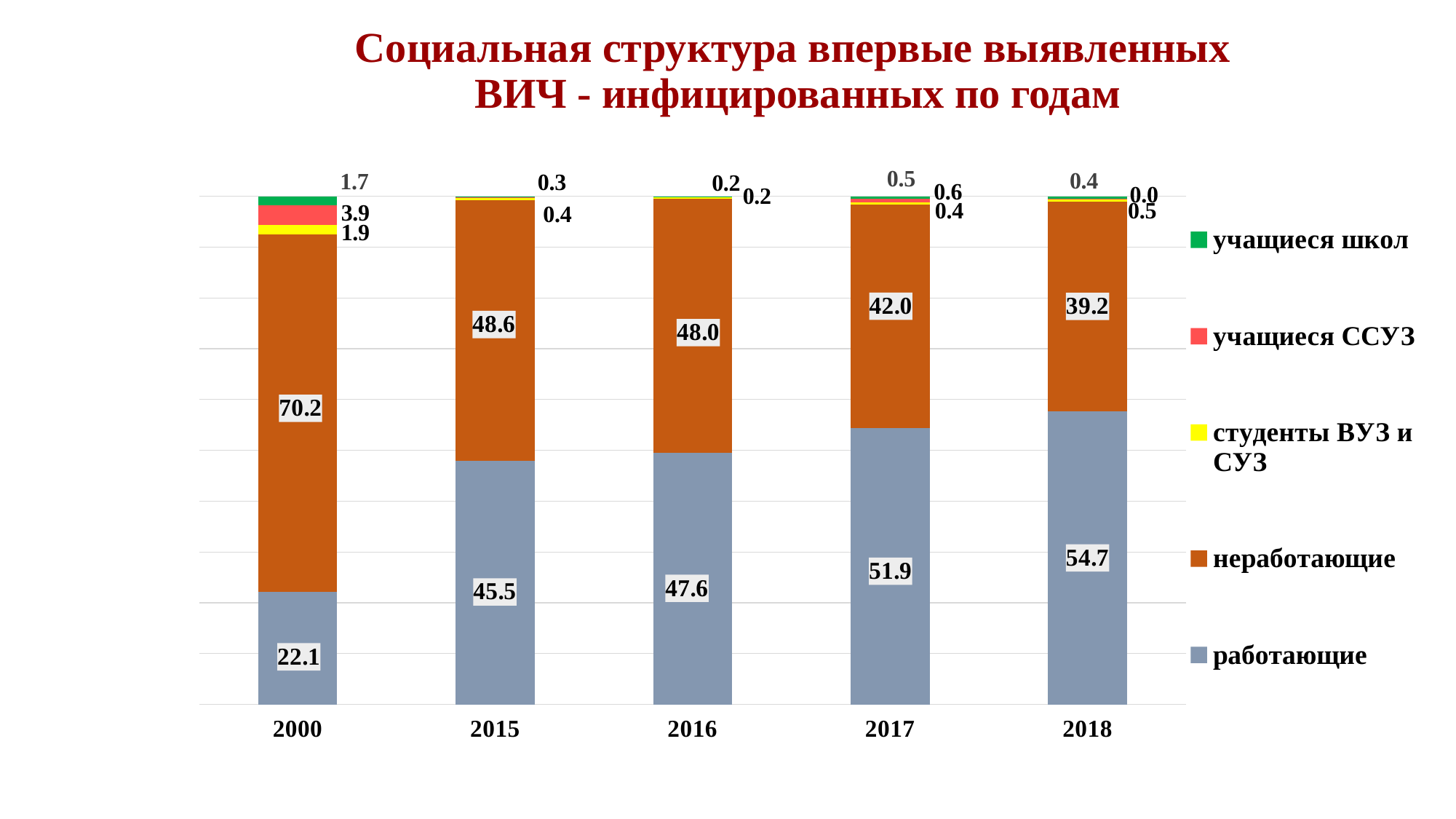
What is the value for работающие in 2000? 22.1 What is the value for неработающие in 2015? 48.6 What is the value for учащиеся ССУЗ in 2000? 3.9 What type of chart is shown on the slide? stacked bar chart In which year is the value for неработающие the lowest? 2018 What is the value for работающие in 2018? 54.7 How many years are shown on the x axis of the chart? 5 Which is larger in 2017: the value for работающие or the value for неработающие? работающие Do the values for работающие rise or fall from 2000 to 2018? rise In which year is the value for работающие the highest? 2018 What is the difference between the работающие values for 2018 and 2000? 32.6 How many series does the legend list? 5